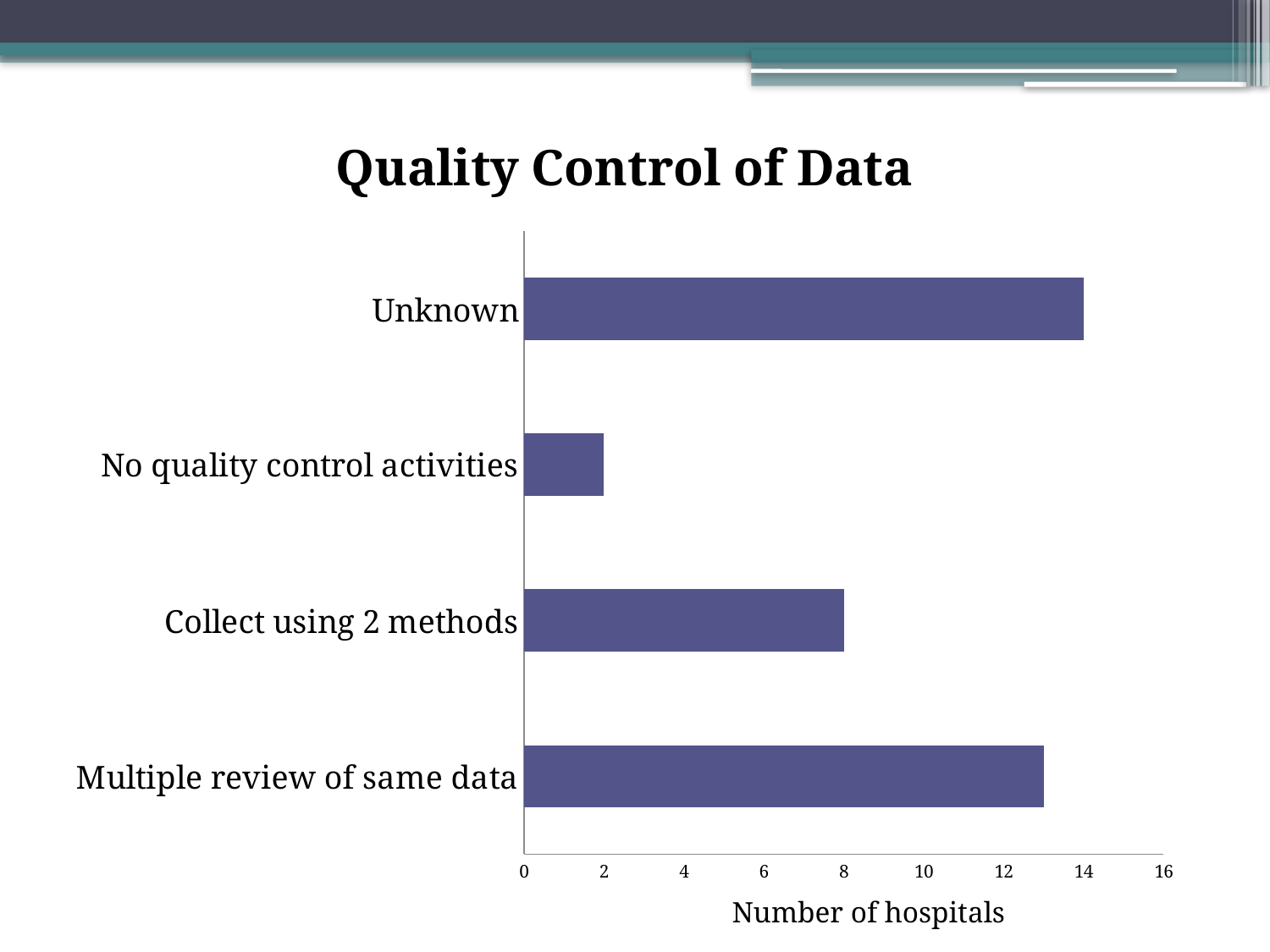
Which category has the lowest number of hospitals? No quality control activities Which category has the highest number of hospitals? Unknown How many hospitals are in the 'Unknown' category? 14 How many categories are shown in the chart? 4 Which has more hospitals: 'Collect using 2 methods' or 'No quality control activities'? Collect using 2 methods What is the title of the chart? Quality Control of Data How many hospitals 'Collect using 2 methods'? 8 What is the difference between the number of hospitals for 'Unknown' and 'Collect using 2 methods'? 6 How many hospitals reported 'No quality control activities'? 2 Is the value for 'Multiple review of same data' greater or less than 12? greater What kind of chart is shown on the slide? bar chart What is the label of the horizontal axis? Number of hospitals